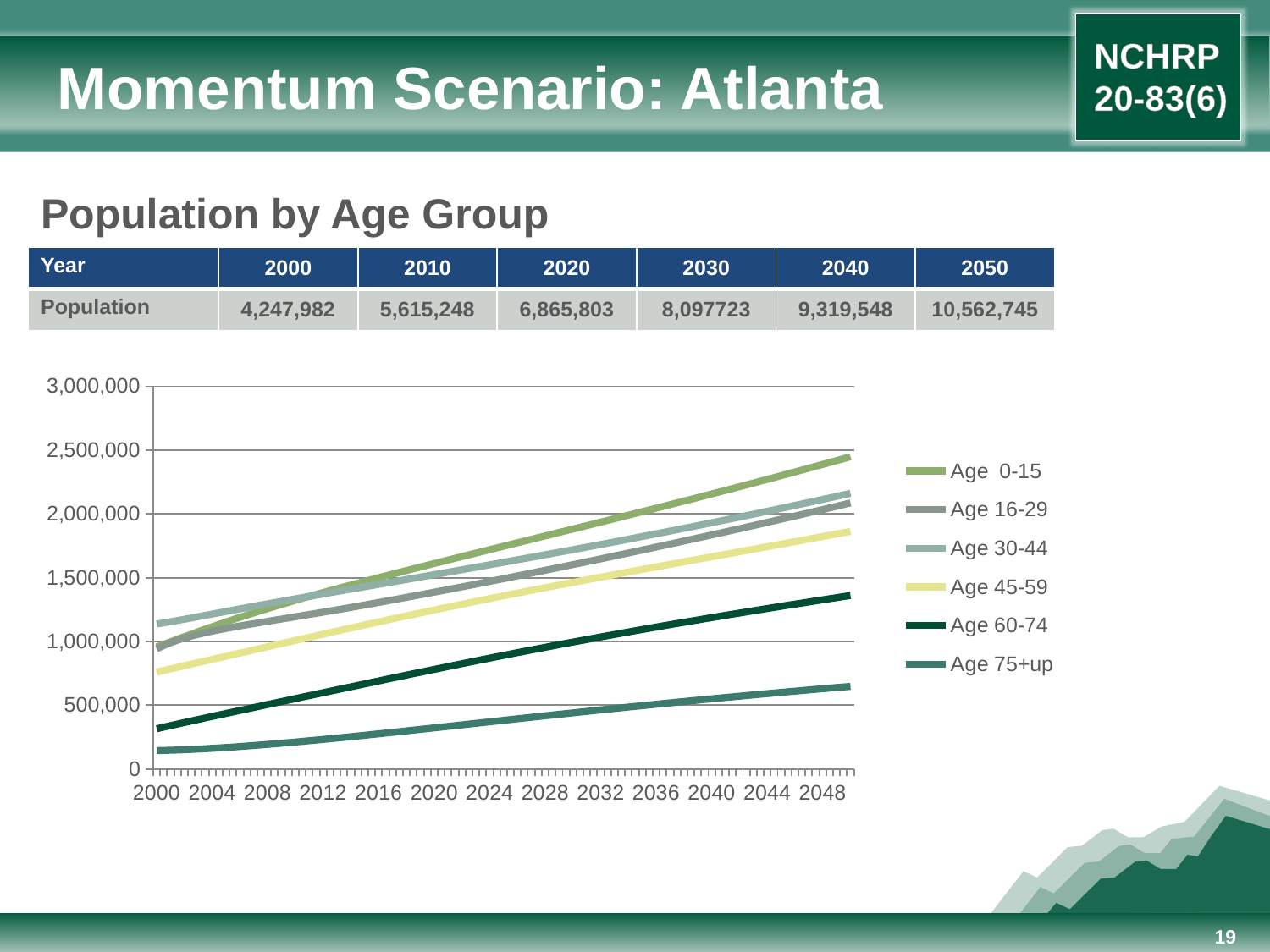
Is the value for Age 45-59 at 2000 greater or less than 1,000,000? less Is the value for Age 0-15 at 2050 greater or less than 2,000,000? greater Is the value for Age 60-74 at 2000 greater or less than 500,000? less How many series does the chart's legend list? 6 Which age group has the lowest value across the whole chart? Age 75+up Which series is drawn with the yellow line? Age 45-59 Does the Age 0-15 line rise or fall from 2000 to 2050? rises What kind of chart is shown on the slide? line chart Which series is drawn with the darkest green line? Age 60-74 Which age group has the highest value at the right end of the chart (2050)? Age 0-15 At 2050, which is larger: Age 45-59 or Age 60-74? Age 45-59